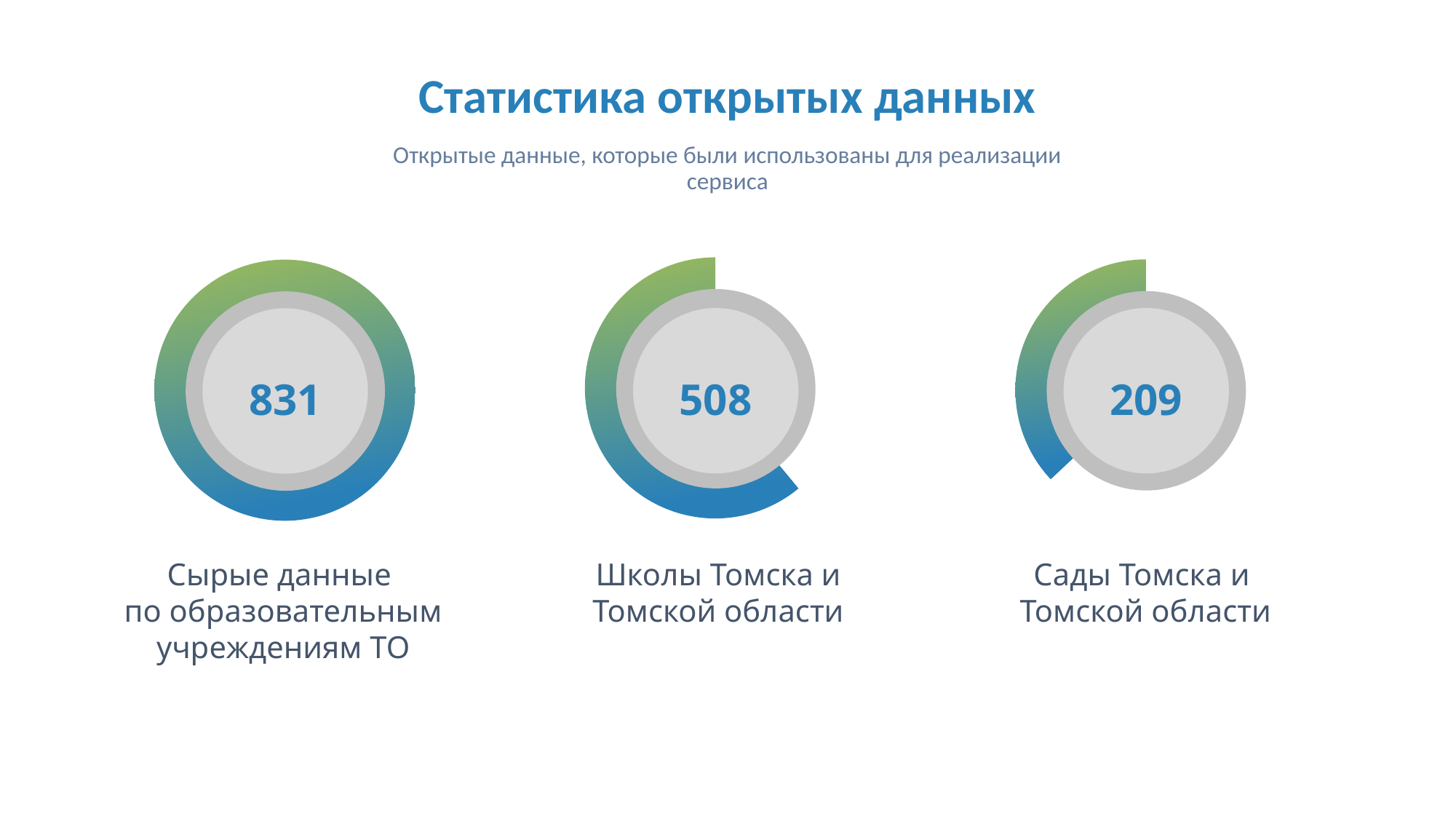
What value is shown in the left chart labelled "Сырые данные по образовательным учреждениям ТО"? 831 What value is shown in the right chart labelled "Сады Томска и Томской области"? 209 What is the difference between the value in the middle chart (Школы Томска и Томской области) and the value in the right chart (Сады Томска и Томской области)? 299 Across the three ring charts on the slide, which category has the highest value? Сырые данные по образовательным учреждениям ТО Across the three ring charts on the slide, which category has the lowest value? Сады Томска и Томской области Which of the three ring charts has its coloured ring filled all the way around? The left chart (Сырые данные по образовательным учреждениям ТО) What kind of chart is used for each of the three figures on the slide? Donut (ring) chart What is the difference between the value in the left chart (Сырые данные) and the value in the middle chart (Школы Томска и Томской области)? 323 How many ring charts are shown on the slide? 3 Which is larger: the value in the middle chart (Школы Томска и Томской области) or the value in the right chart (Сады Томска и Томской области)? Школы Томска и Томской области What is the title of the slide containing the three ring charts? Статистика открытых данных What value is shown in the middle chart labelled "Школы Томска и Томской области"? 508